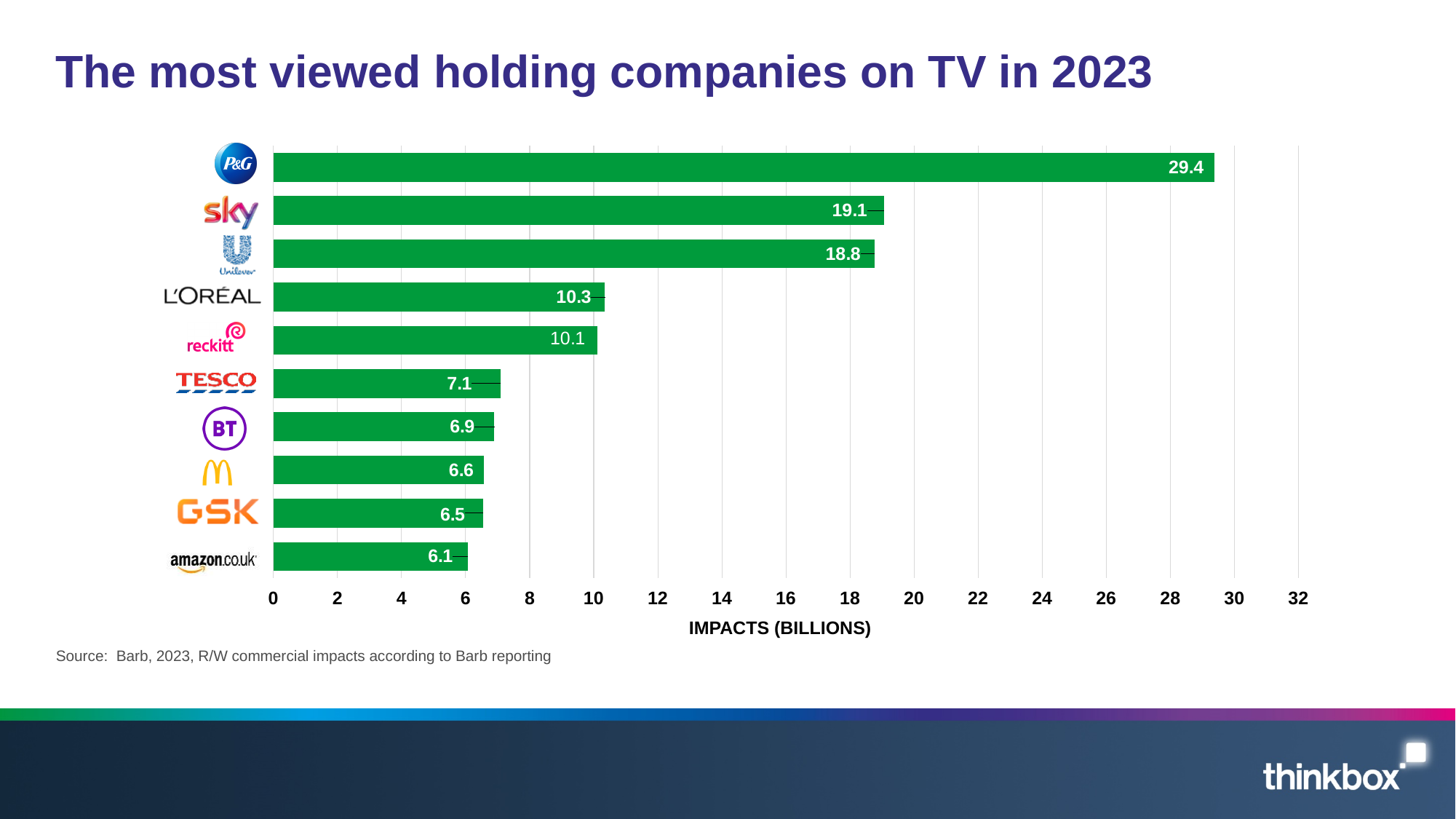
What kind of chart is this? Bar chart What is the value for Unilever? 18.8 What is the difference between the values for P&G and Sky? 10.3 What is the difference between the values for L'Oréal and Reckitt? 0.2 What is the value for Sky? 19.1 What is the label of the horizontal axis? IMPACTS (BILLIONS) What is the value for P&G? 29.4 How many companies are shown in the chart? 10 Which company has the highest value? P&G Which is larger, the value for Sky or the value for Unilever? Sky Which company has the lowest value? amazon.co.uk What is the value for Tesco? 7.1